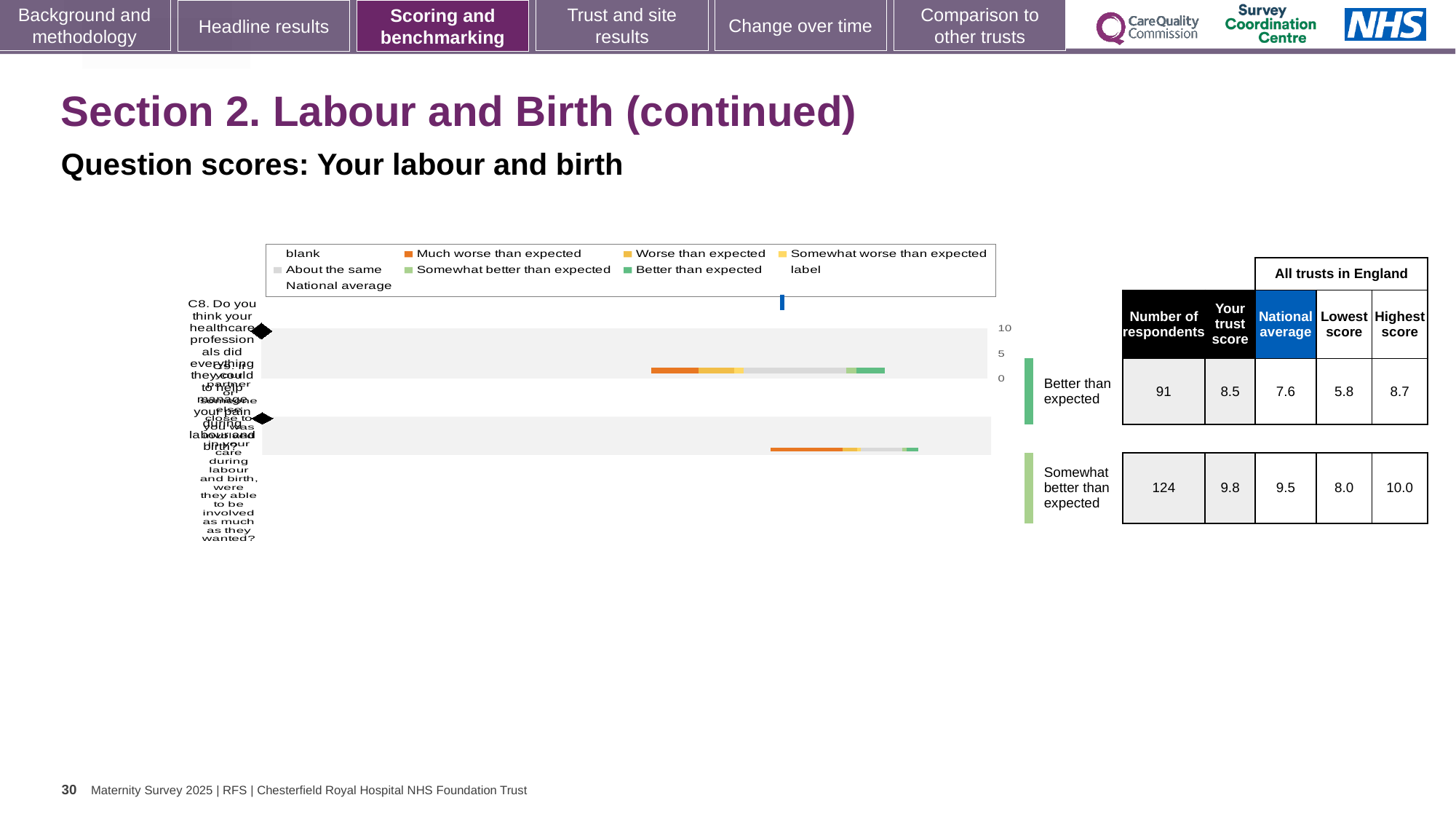
What is the national average for the row rated 'Better than expected'? 7.6 What is the highest tick value shown on the chart's score axis? 10 How many respondents are listed for the row rated 'Better than expected'? 91 How many respondents are listed for the row rated 'Somewhat better than expected'? 124 In the legend, what colour represents 'Much worse than expected'? Orange What kind of chart is shown on the slide? Bar chart What is the highest score among all trusts in England for the row rated 'Better than expected'? 8.7 What is the trust score for the row rated 'Better than expected'? 8.5 For the row rated 'Better than expected', which is larger: the trust score or the national average? Trust score For the row rated 'Somewhat better than expected', what is the difference between the trust score and the national average? 0.3 How many question rows (bars) are plotted in the chart? 2 What is the lowest score among all trusts in England for the row rated 'Somewhat better than expected'? 8.0